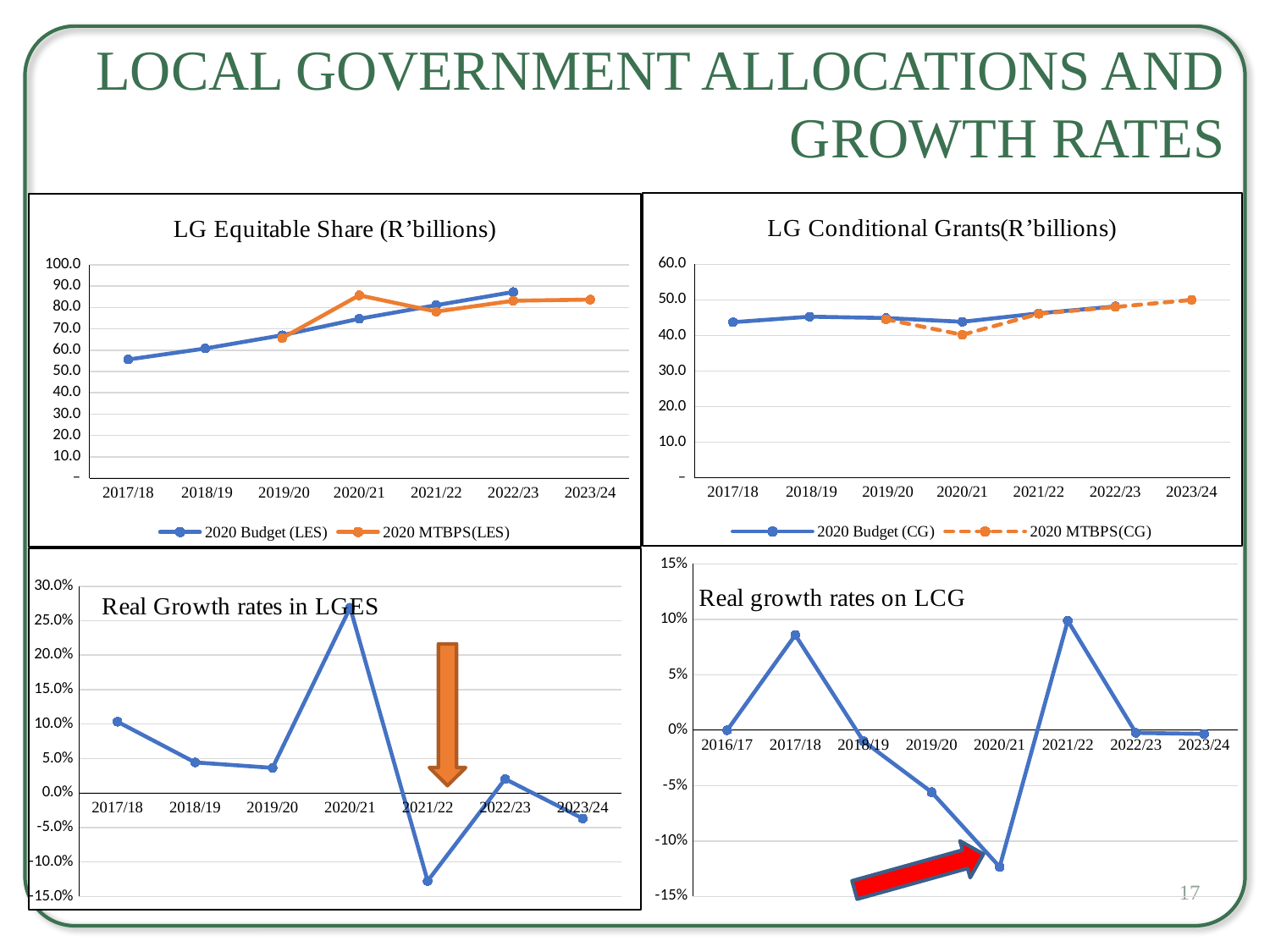
In the Real Growth rates in LGES chart, which year has the highest growth rate? 2020/21 In the LG Conditional Grants(R'billions) chart, is the 2020 Budget (CG) value for 2017/18 greater or less than 50.0? less How many data points are plotted in the Real growth rates on LCG chart? 8 What are the two legend entries of the LG Conditional Grants(R'billions) chart? 2020 Budget (CG) and 2020 MTBPS(CG) How many series does the legend of the LG Equitable Share (R'billions) chart list? 2 In the LG Equitable Share (R'billions) chart, is the 2020 MTBPS(LES) value for 2020/21 greater or less than 80.0? greater In the Real Growth rates in LGES chart, which year has the lowest growth rate? 2021/22 In the Real growth rates on LCG chart, which year has the lowest growth rate? 2020/21 In the LG Equitable Share (R'billions) chart, is the 2020 Budget (LES) value for 2017/18 greater or less than 60.0? less In the LG Equitable Share (R'billions) chart, which series has the higher value in 2020/21? 2020 MTBPS(LES) In the LG Equitable Share (R'billions) chart, does the 2020 Budget (LES) series rise or fall from 2017/18 to 2022/23? rise What kind of chart is the LG Equitable Share (R'billions) chart? line chart